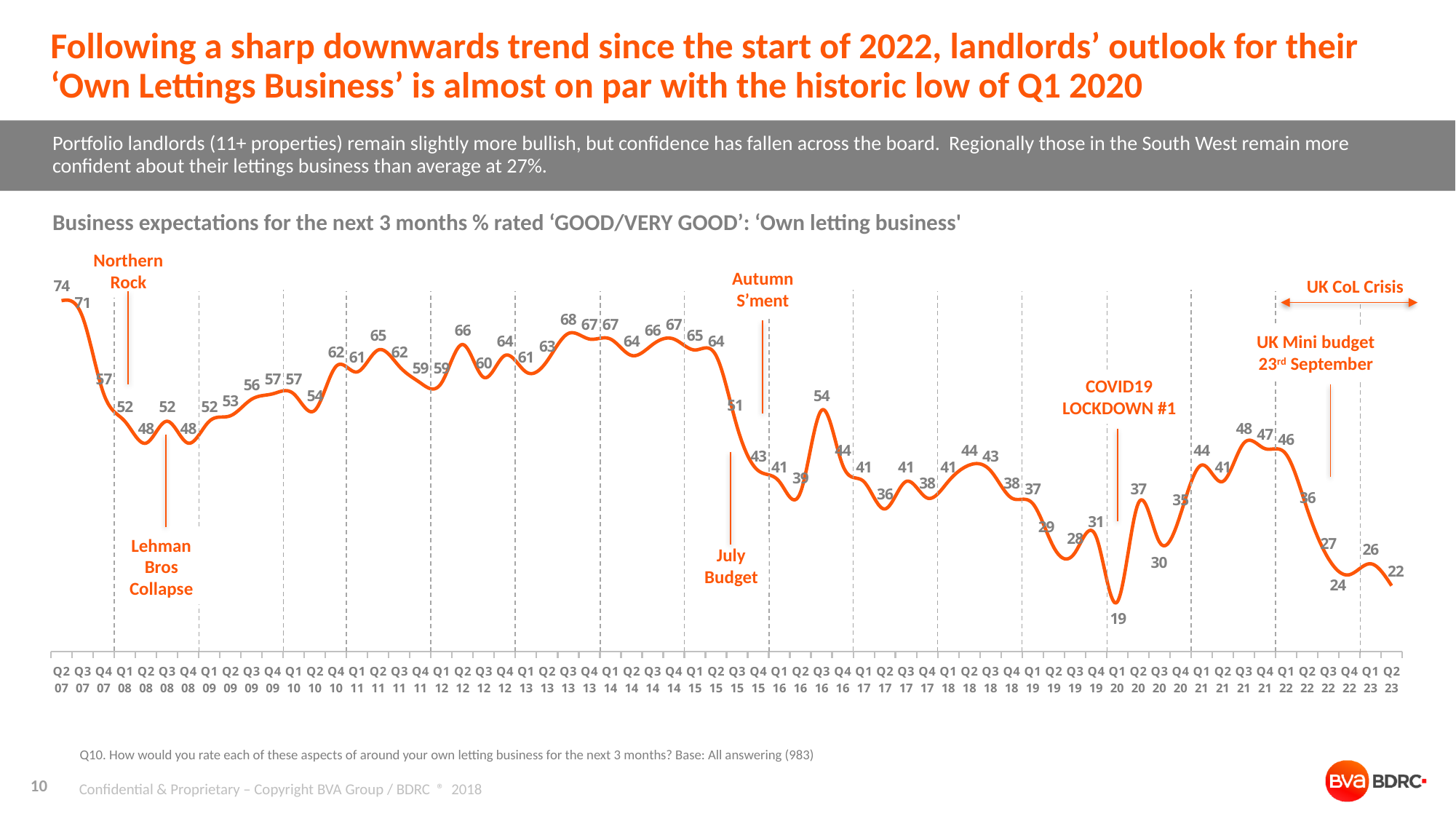
What is the value for Q3 16? 54 What type of chart is shown on the slide? Line chart Which quarter has the highest value? Q2 07 What is the value for Q1 20? 19 Which quarter has the lowest value? Q1 20 Which event is annotated on the chart near Q3 08? Lehman Bros Collapse What is the value for Q2 07? 74 What is the difference between the values for Q2 07 and Q2 23? 52 Do the values rise or fall from Q1 22 to Q4 22? Fall Which is larger, the value for Q3 13 or the value for Q2 12? Q3 13 What is the difference between the values for Q1 22 and Q2 23? 24 What is the value for Q2 23? 22